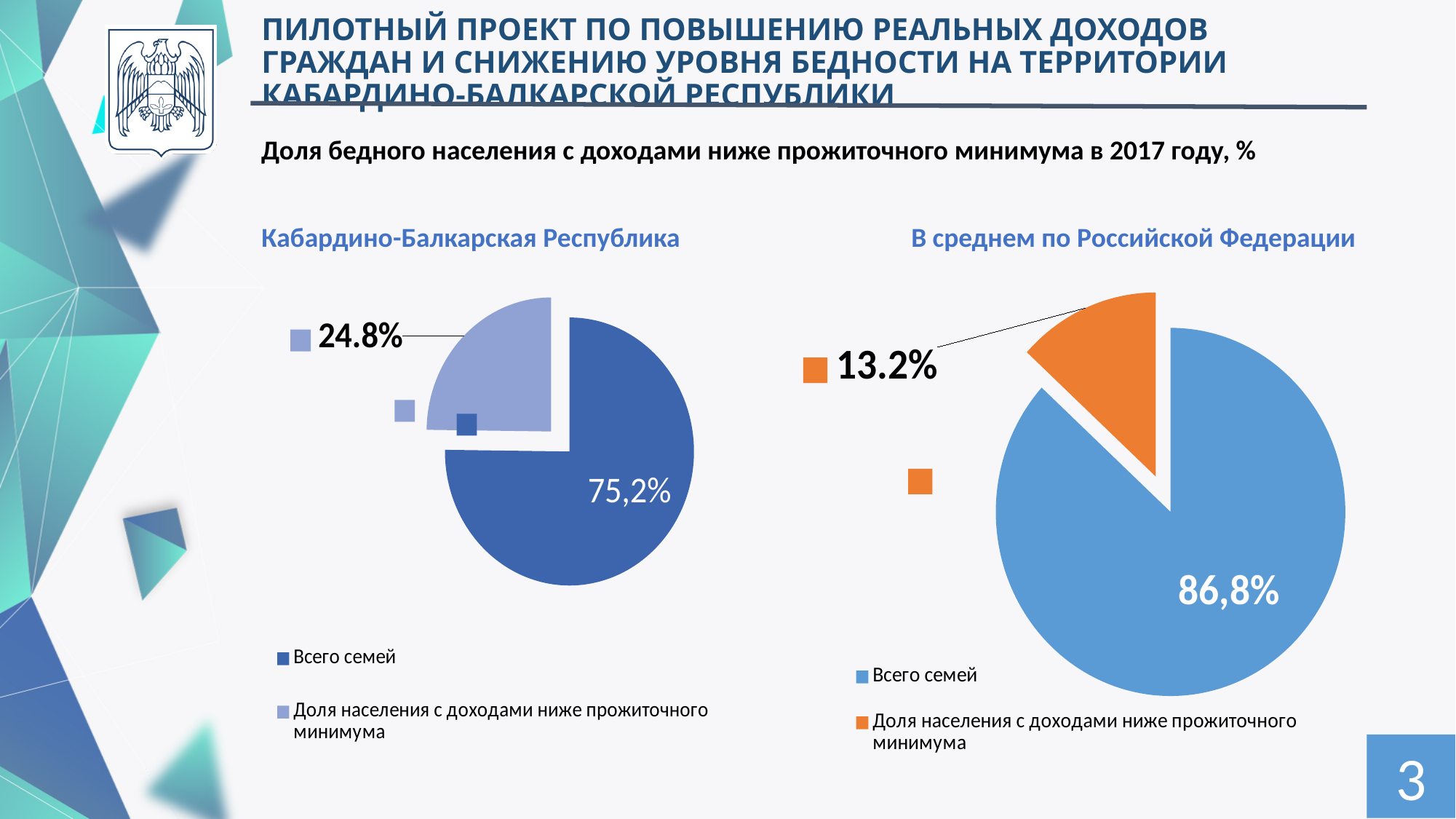
In the 'Кабардино-Балкарская Республика' chart, what value is shown for 'Всего семей'? 75,2% In the 'В среднем по Российской Федерации' chart, what value is shown for 'Всего семей'? 86,8% Which is larger: the 'Доля населения с доходами ниже прожиточного минимума' slice in the 'Кабардино-Балкарская Республика' chart or in the 'В среднем по Российской Федерации' chart? Кабардино-Балкарская Республика In the 'В среднем по Российской Федерации' chart, what value is shown for 'Доля населения с доходами ниже прожиточного минимума'? 13.2% How many slices does the 'В среднем по Российской Федерации' pie chart have? 2 In the 'Кабардино-Балкарская Республика' chart, which slice is the largest? Всего семей How many pie charts are shown on the slide? 2 What colour is the 'Доля населения с доходами ниже прожиточного минимума' slice in the 'В среднем по Российской Федерации' chart? orange How many entries does the legend of the 'Кабардино-Балкарская Республика' chart list? 2 What type of chart is used for the 'Кабардино-Балкарская Республика' chart? pie chart In the 'Кабардино-Балкарская Республика' chart, what value is shown for 'Доля населения с доходами ниже прожиточного минимума'? 24.8% In the 'В среднем по Российской Федерации' chart, which slice is the smallest? Доля населения с доходами ниже прожиточного минимума